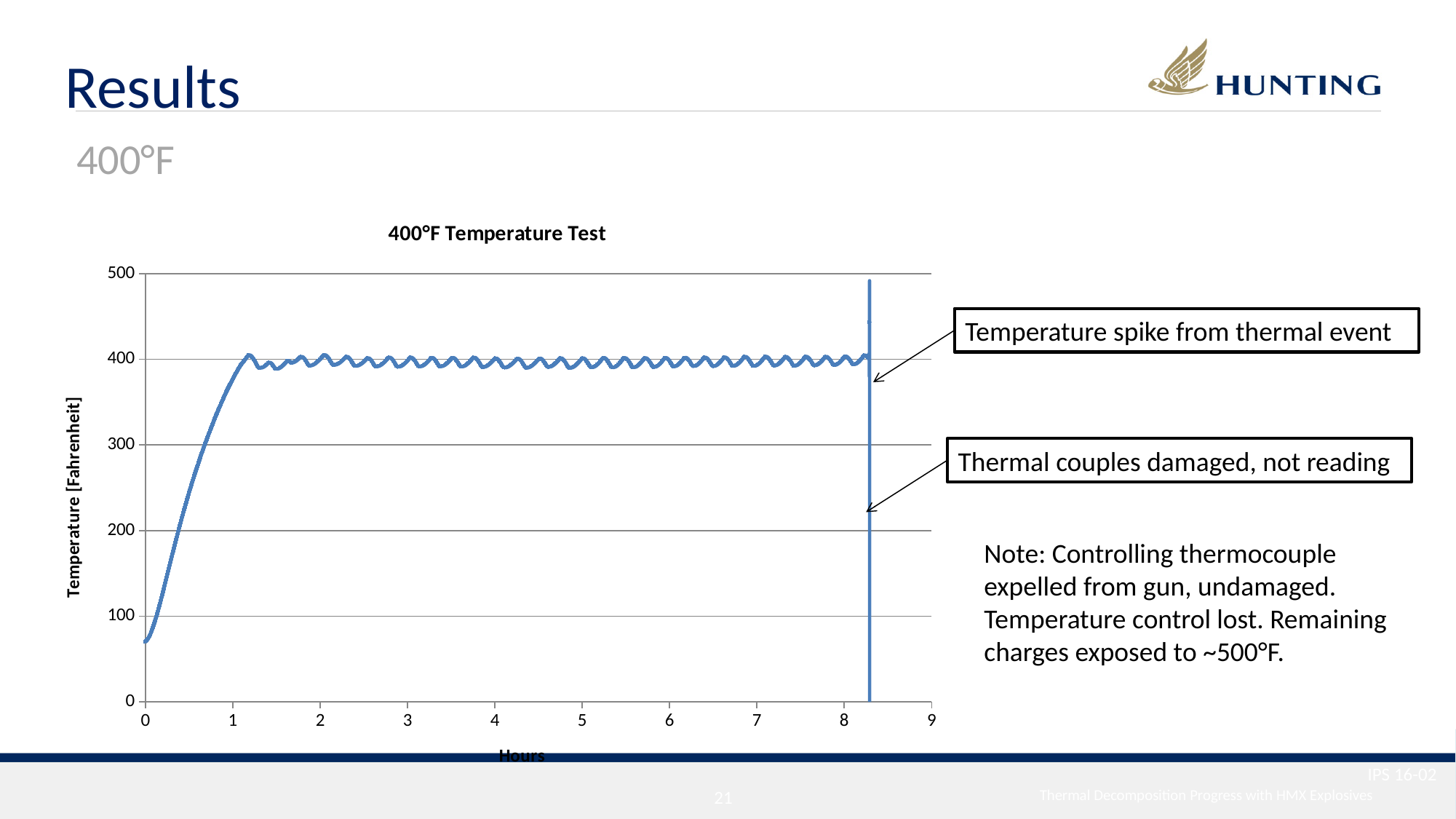
Is the temperature at 6 hours greater or less than 200? greater What is the title of the chart? 400°F Temperature Test Is the temperature at 0.5 hours greater or less than 400? less What is the highest value shown on the vertical axis of the chart? 500 Does the temperature rise or fall between 0 and 1 hours? rise What kind of chart is shown on the slide? line chart What is the highest value shown on the horizontal axis of the chart? 9 Which is larger, the temperature at 0 hours or the temperature at 2 hours? the temperature at 2 hours Is the temperature at 0 hours greater or less than 100? less